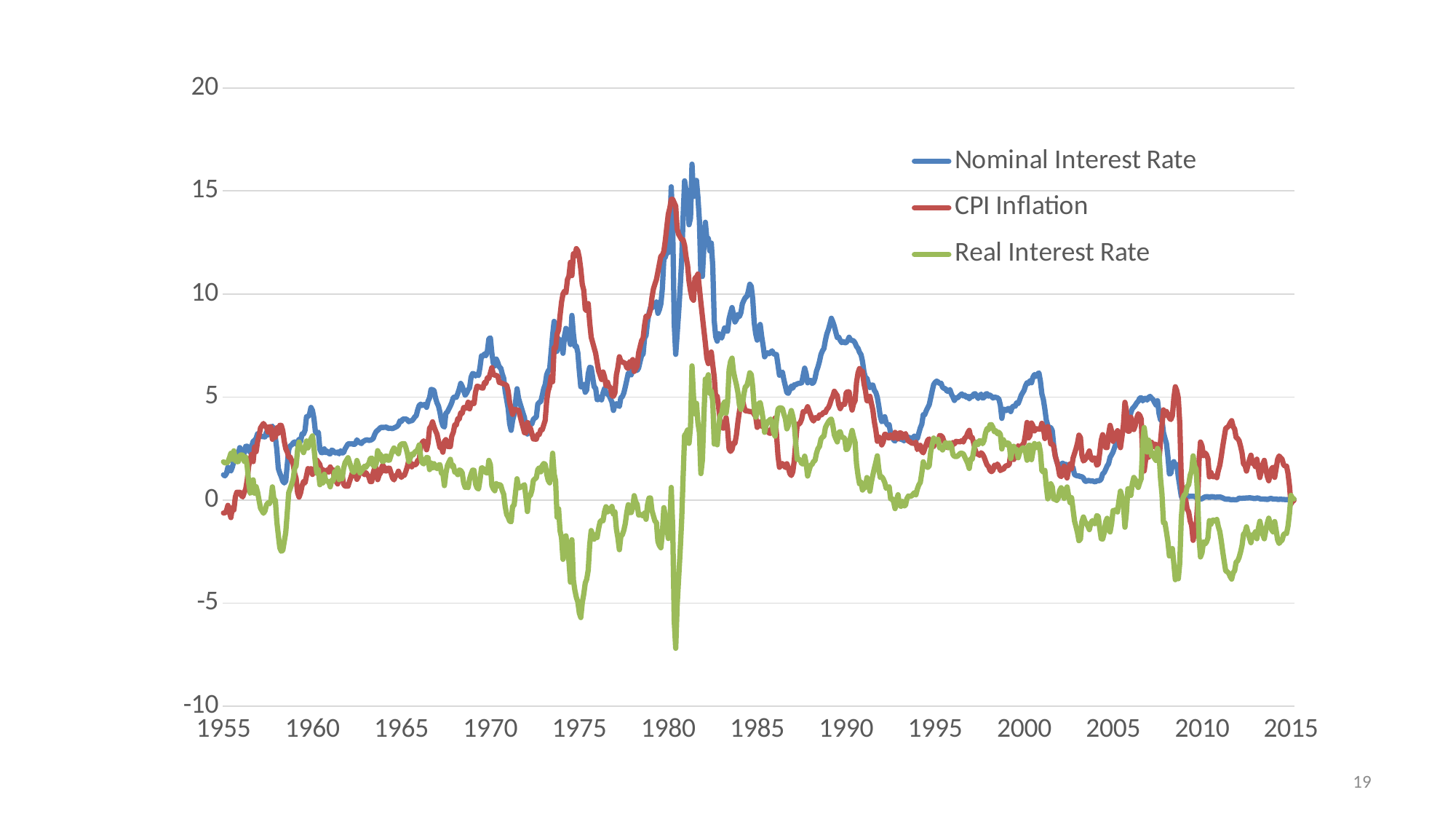
Is the peak value of the Nominal Interest Rate around 1981 greater or less than 15? greater Which series reaches the lowest value anywhere on the chart? Real Interest Rate Which series reaches the highest value anywhere on the chart? Nominal Interest Rate How many series does the legend list? 3 Is the Nominal Interest Rate in 2012 greater or less than 5? less What colour is the CPI Inflation line? Red Which series is drawn in green? Real Interest Rate Does the Nominal Interest Rate generally rise or fall from 1981 to 2015? Fall Is the lowest value of the Real Interest Rate around 1980 greater or less than -5? less Around 1975, which is higher: CPI Inflation or the Nominal Interest Rate? CPI Inflation What kind of chart is shown on the slide? Line chart